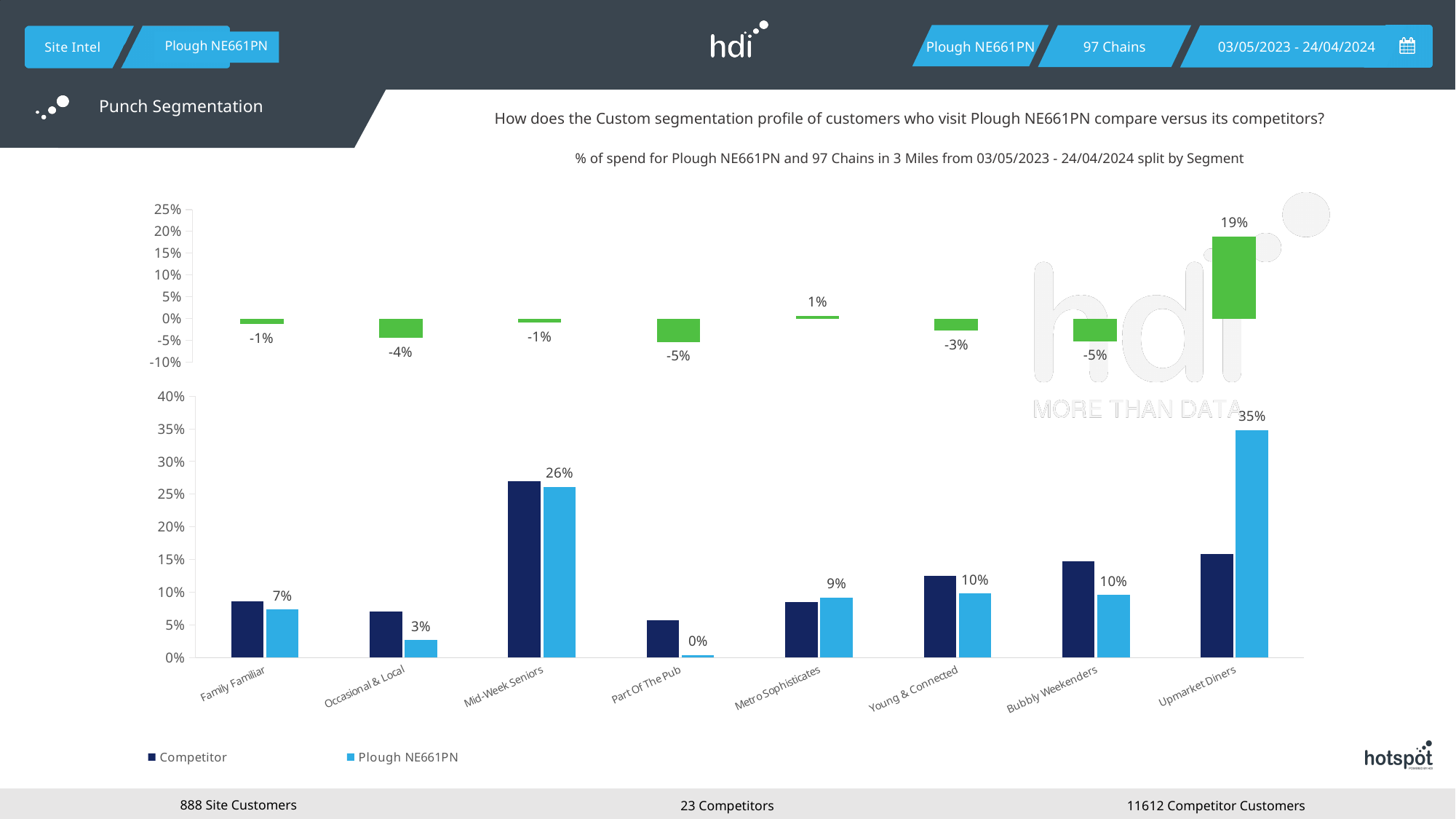
In the bottom chart, what is the Plough NE661PN value for Upmarket Diners? 35% In the bottom chart, is the Competitor value for Mid-Week Seniors greater or less than 25%? greater In the top chart, what is the value shown for Occasional & Local? -4% In the bottom chart, which segment has the lowest Plough NE661PN value? Part Of The Pub What kind of chart is the bottom chart? bar chart In the bottom chart, what is the difference between the Plough NE661PN values for Upmarket Diners and Mid-Week Seniors? 9% In the bottom chart, for Upmarket Diners, which is larger: the Competitor bar or the Plough NE661PN bar? Plough NE661PN In the bottom chart, what is the Plough NE661PN value for Mid-Week Seniors? 26% In the top chart, which segment has the highest value? Upmarket Diners In the top chart, what is the value shown for Upmarket Diners? 19% How many segments are shown on the x axis of the bottom chart? 8 How many series does the legend of the bottom chart list? 2